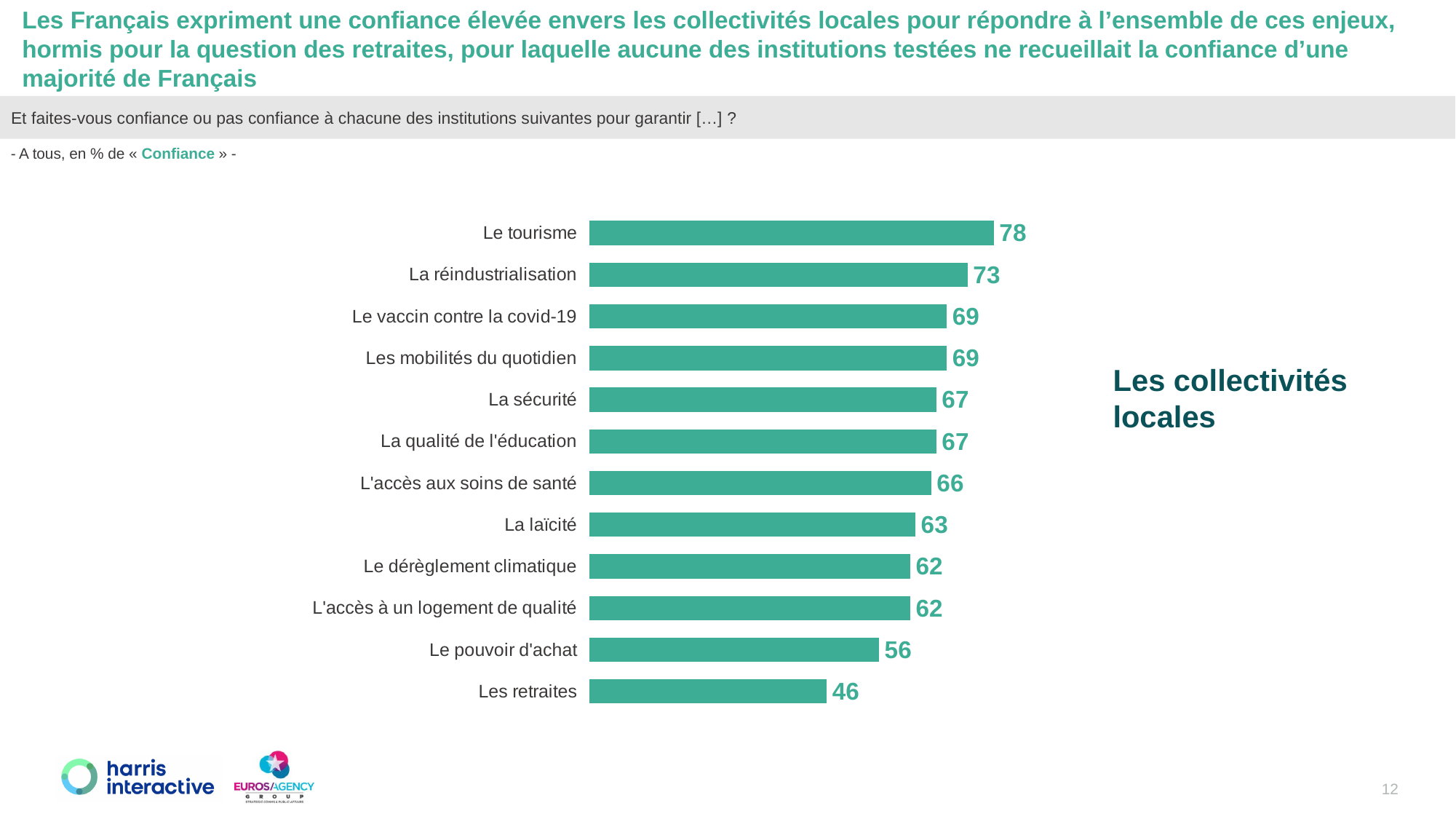
What is the value for Les retraites? 46 Which institution does the chart refer to, according to the label to the right of the bars? Les collectivités locales Which category has the lowest value? Les retraites What is the value for Le pouvoir d'achat? 56 How many categories are shown in the chart? 12 What is the value for Le tourisme? 78 What is the difference between the values for La réindustrialisation and Le pouvoir d'achat? 17 Which category has the highest value? Le tourisme What kind of chart is shown on the slide? Bar chart What is the difference between the values for Le tourisme and Les retraites? 32 Which is larger, the value for La sécurité or the value for Le dérèglement climatique? La sécurité What is the value for La laïcité? 63